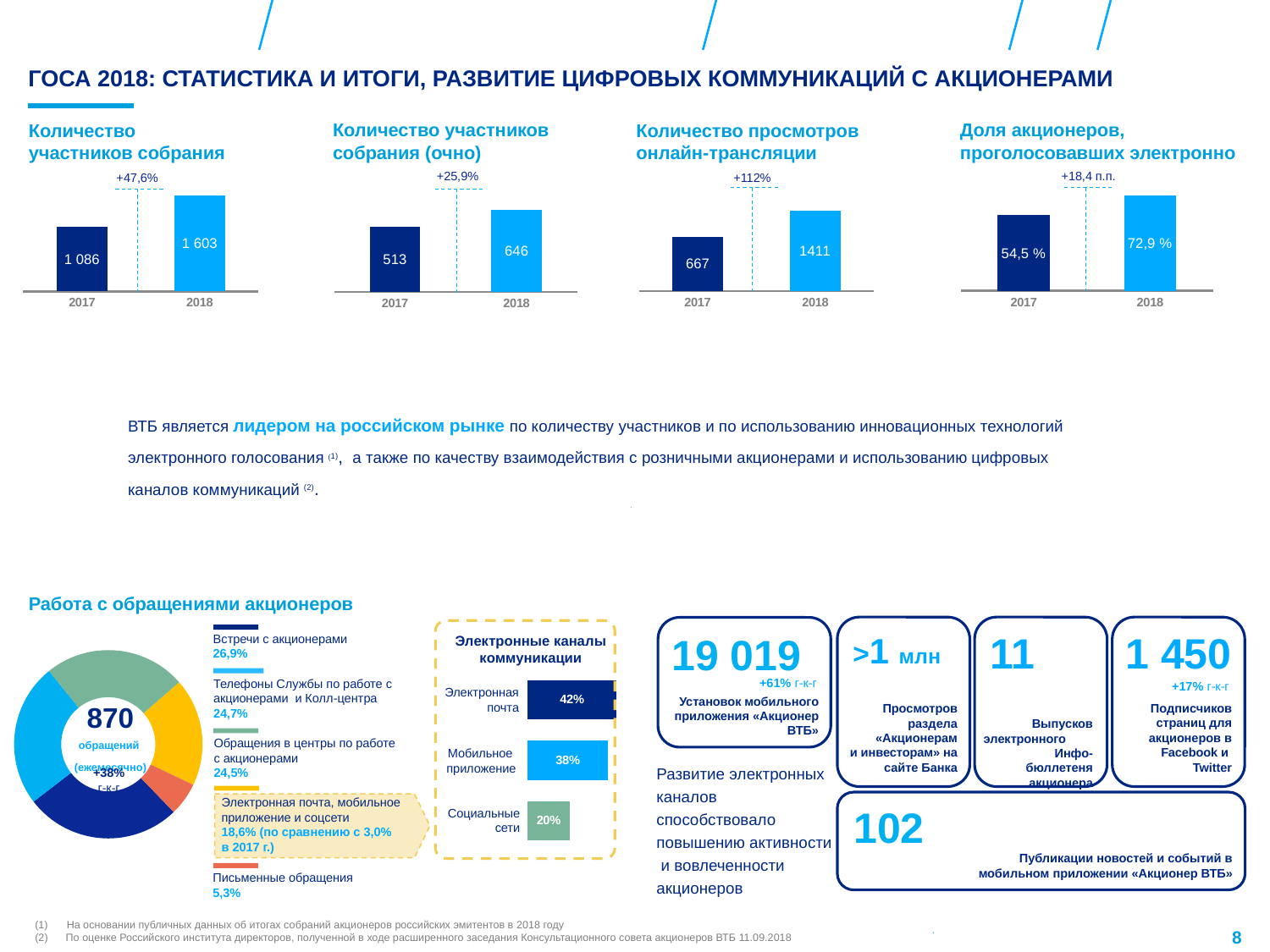
In the chart 'Количество просмотров онлайн-трансляции', what is the difference between the 2018 and 2017 values? 744 In the chart 'Количество участников собрания (очно)', which year has the higher value, 2017 or 2018? 2018 In the chart 'Количество участников собрания', what percentage change is shown between 2017 and 2018? +47,6% In the chart 'Количество участников собрания (очно)', what is the value for 2017? 513 In the chart 'Количество просмотров онлайн-трансляции', what is the value for 2018? 1411 What type of chart is 'Электронные каналы коммуникации'? bar chart In the chart 'Количество участников собрания', what is the value for 2018? 1 603 How many categories are shown in the chart 'Электронные каналы коммуникации'? 3 In the donut chart under 'Работа с обращениями акционеров', what share is shown for 'Письменные обращения'? 5,3% In the chart 'Электронные каналы коммуникации', which category has the lowest value? Социальные сети In the chart 'Доля акционеров, проголосовавших электронно', what is the value for 2017? 54,5 % In the chart 'Электронные каналы коммуникации', what is the value for 'Мобильное приложение'? 38%